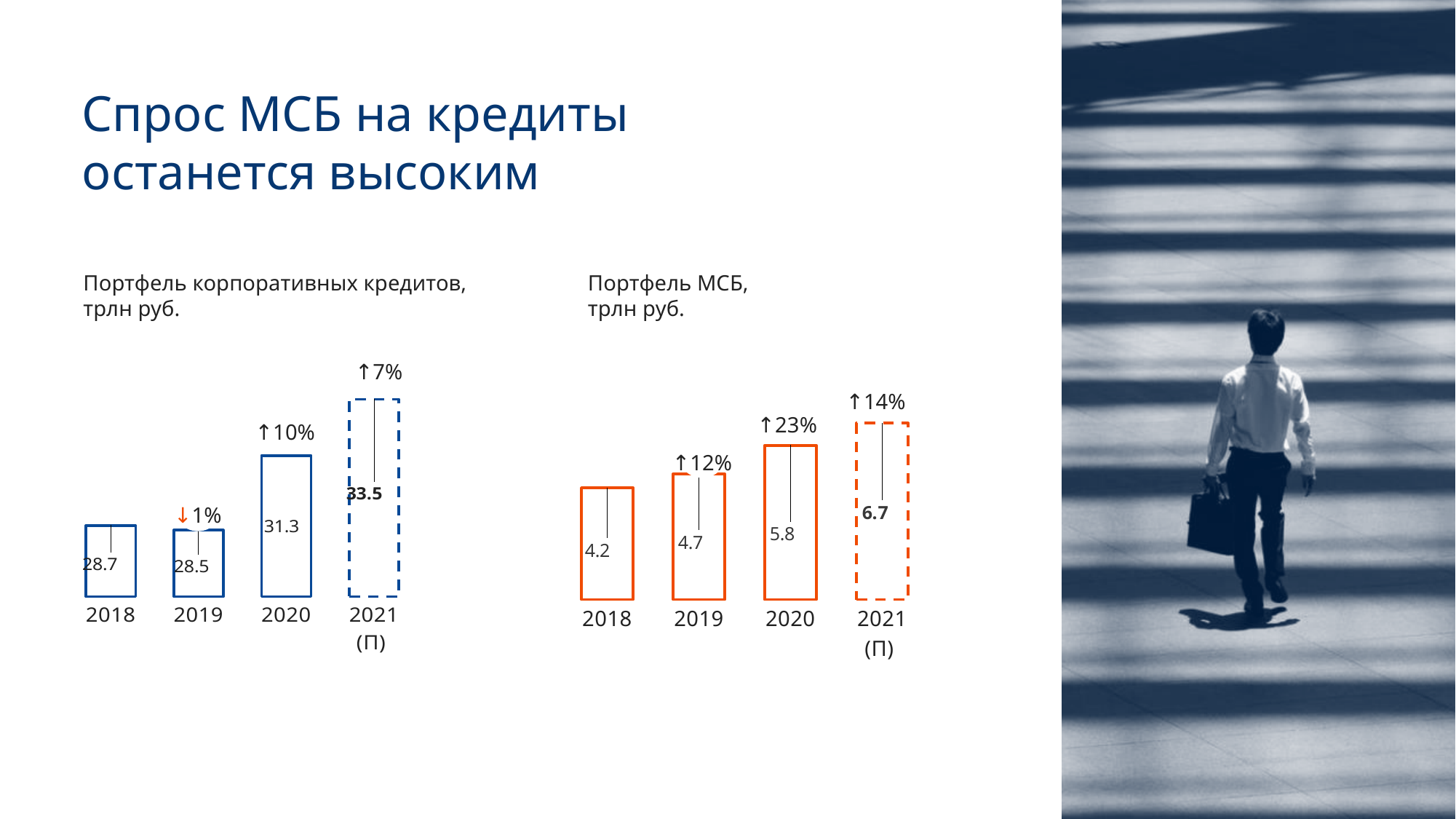
In the 'Портфель МСБ, трлн руб.' chart, what is the value for 2019? 4.7 In the 'Портфель МСБ, трлн руб.' chart, what percentage growth is labelled above the 2020 bar? ↑23% In the 'Портфель корпоративных кредитов, трлн руб.' chart, which is larger: the value for 2018 or the value for 2019? 2018 In the 'Портфель МСБ, трлн руб.' chart, what is the forecast value for 2021 (П)? 6.7 In the 'Портфель корпоративных кредитов, трлн руб.' chart, what is the value for 2020? 31.3 In the 'Портфель корпоративных кредитов, трлн руб.' chart, what is the difference between the 2021 (П) value and the 2020 value? 2.2 In the 'Портфель МСБ, трлн руб.' chart, which year has the highest value? 2021 (П) In the 'Портфель МСБ, трлн руб.' chart, do the values rise or fall from 2018 to 2021 (П)? Rise In the 'Портфель МСБ, трлн руб.' chart, what is the difference between the 2020 value and the 2018 value? 1.6 What type of chart is the 'Портфель корпоративных кредитов, трлн руб.' chart? Bar chart In the 'Портфель корпоративных кредитов, трлн руб.' chart, which year has the lowest value? 2019 How many years are shown in the 'Портфель МСБ, трлн руб.' chart? 4